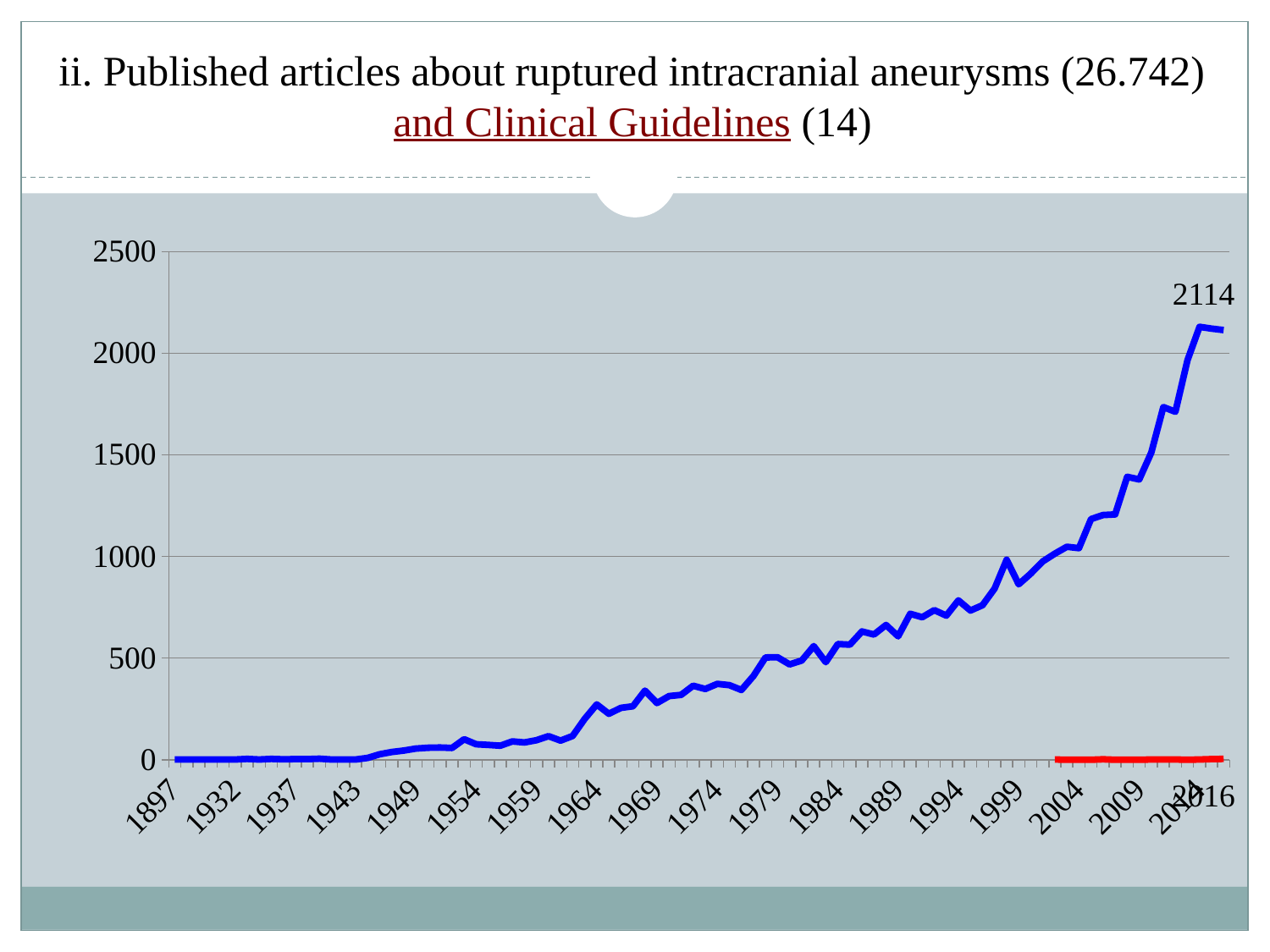
What kind of chart is shown on the slide? line chart What colour is the main line showing published articles? blue Is the value of the blue line at 1949 greater or less than 500? less Which has a larger value on the blue line, 1964 or 1984? 1984 Is the value of the blue line at 1964 greater or less than 500? less Overall, do the values of the blue line rise or fall from 1897 to 2016? rise Is the value of the blue line at 1999 greater or less than 500? greater What is the first year label on the horizontal axis? 1897 What is the maximum value shown on the vertical axis? 2500 Which has a larger value on the blue line, 1989 or 2009? 2009 What is the highest value labelled on the blue line? 2114